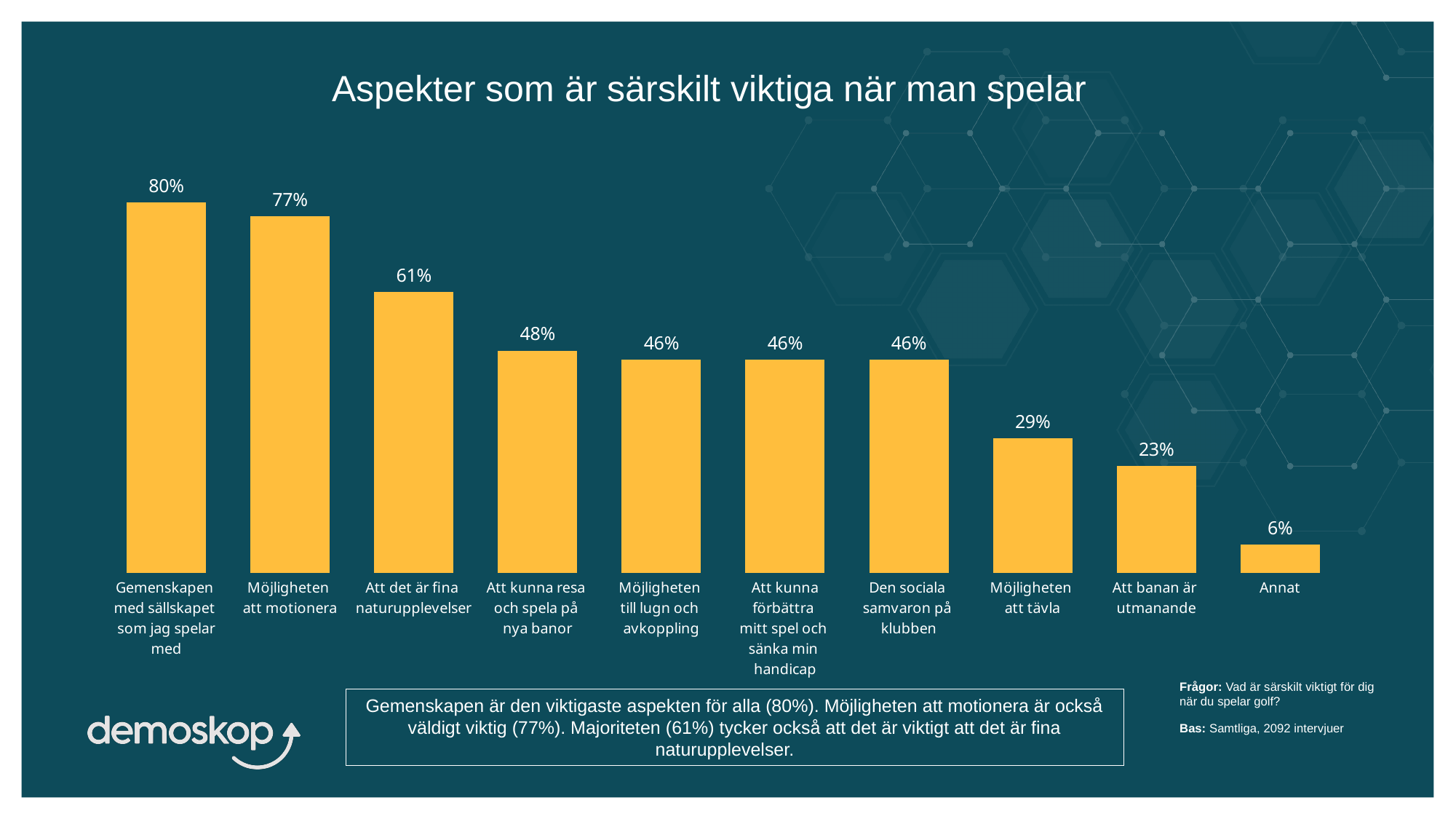
What is the value for "Möjligheten att motionera"? 77% What is the value for "Möjligheten att tävla"? 29% Which is larger: the value for "Att det är fina naturupplevelser" or the value for "Den sociala samvaron på klubben"? Att det är fina naturupplevelser Which category has the lowest value? Annat Which category has the highest value? Gemenskapen med sällskapet som jag spelar med What is the difference between the values for "Att kunna resa och spela på nya banor" and "Att banan är utmanande"? 25 percentage points What is the title of the chart? Aspekter som är särskilt viktiga när man spelar What is the difference between the values for "Gemenskapen med sällskapet som jag spelar med" and "Möjligheten att motionera"? 3 percentage points How many categories are shown in the chart? 10 What kind of chart is shown on the slide? Bar chart What is the value for "Att det är fina naturupplevelser"? 61% What is the value for "Annat"? 6%